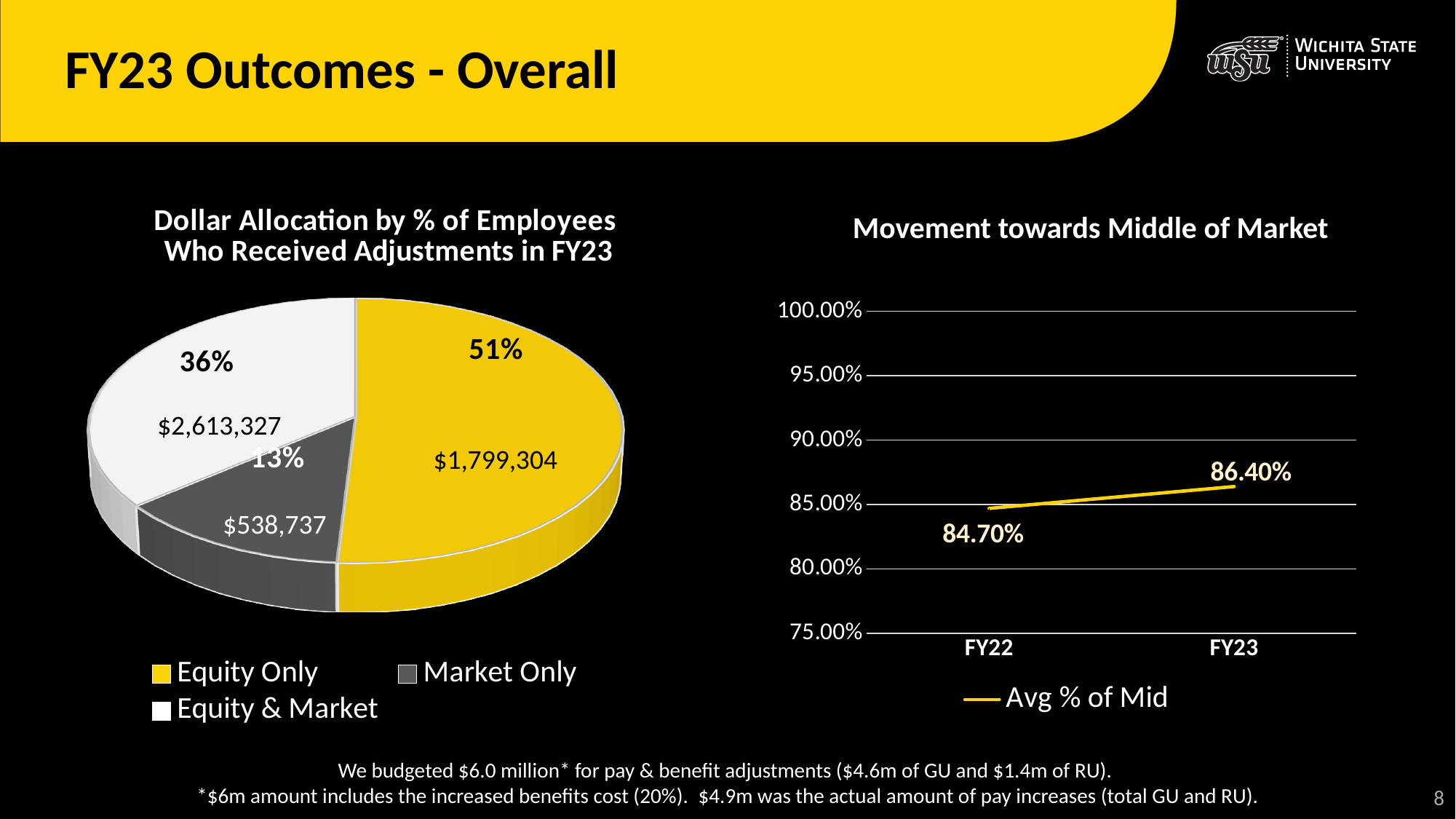
In the 'Dollar Allocation by % of Employees Who Received Adjustments in FY23' chart, which category has the smallest dollar amount? Market Only In the 'Movement towards Middle of Market' chart, what is the Avg % of Mid value for FY22? 84.70% In the 'Dollar Allocation by % of Employees Who Received Adjustments in FY23' chart, what dollar amount is shown for Equity Only? $1,799,304 In the 'Dollar Allocation by % of Employees Who Received Adjustments in FY23' chart, what dollar amount is shown for Equity & Market? $2,613,327 In the 'Movement towards Middle of Market' chart, what is the Avg % of Mid value for FY23? 86.40% In the 'Dollar Allocation by % of Employees Who Received Adjustments in FY23' chart, what is the difference in percentage points between the Equity Only share and the Equity & Market share? 15% In the 'Dollar Allocation by % of Employees Who Received Adjustments in FY23' chart, which category has the largest share of employees? Equity Only In the 'Movement towards Middle of Market' chart, does the Avg % of Mid rise or fall from FY22 to FY23? Rise In the 'Movement towards Middle of Market' chart, what is the difference between the FY23 and FY22 Avg % of Mid values? 1.70% In the 'Dollar Allocation by % of Employees Who Received Adjustments in FY23' chart, how many categories does the legend list? 3 In the 'Dollar Allocation by % of Employees Who Received Adjustments in FY23' chart, what percentage of employees is shown for Market Only? 13% What kind of chart is 'Dollar Allocation by % of Employees Who Received Adjustments in FY23'? Pie chart